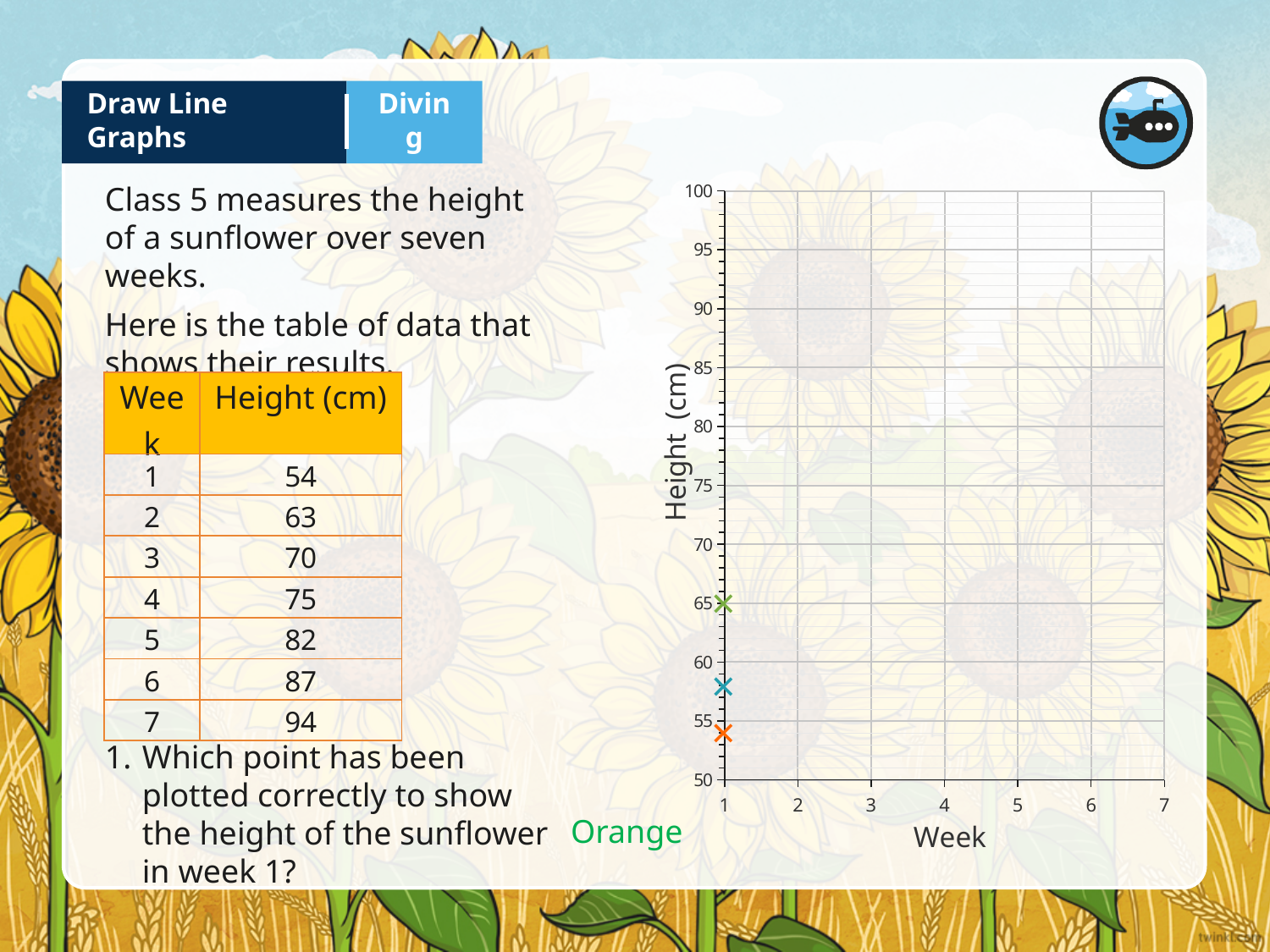
According to the slide, which point has been plotted correctly to show the height of the sunflower in week 1? Orange What height value does the green X on the chart land on? 65 Is the value of the orange X greater or less than 60? less At which week are all the plotted points positioned on the chart? Week 1 Is the value of the blue X greater or less than 65? less Which coloured point is plotted highest on the chart? Green How many points are plotted on the chart? 3 Which coloured point is plotted lowest on the chart? Orange What is the label on the vertical axis of the chart? Height (cm) Which is plotted higher on the chart, the blue X or the orange X? Blue X Is the value of the green X greater or less than 60? greater What is the highest value shown on the vertical axis of the chart? 100